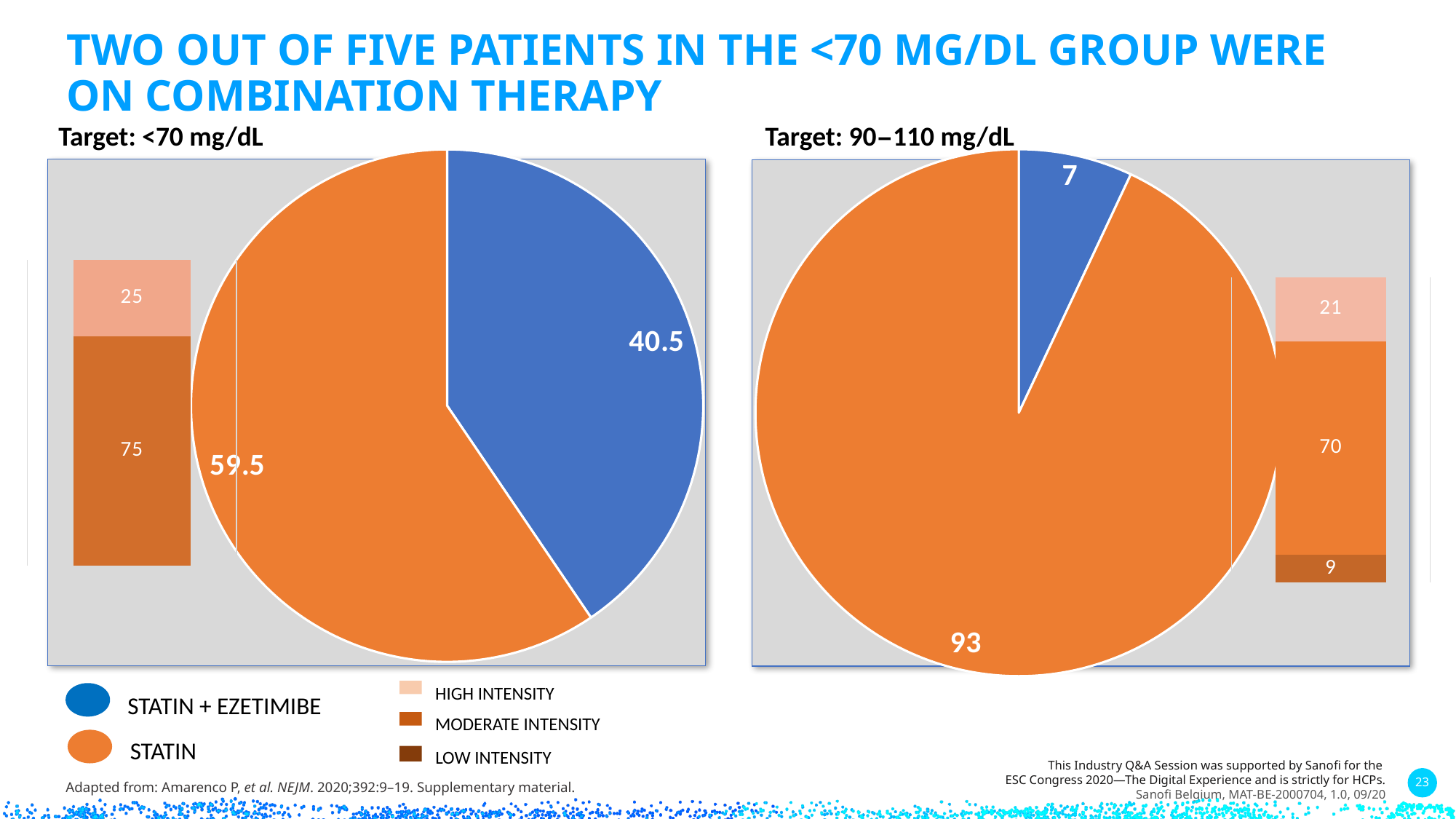
How many intensity categories does the legend list for the stacked bars? 3 In the 'Target: 90–110 mg/dL' pie chart, what is the difference between the STATIN and STATIN + EZETIMIBE values? 86 In the stacked bar next to the 'Target: 90–110 mg/dL' pie chart, what is the total of the three segments? 100 In the stacked bar next to the 'Target: 90–110 mg/dL' pie chart, what is the value for LOW INTENSITY? 9 In the 'Target: 90–110 mg/dL' pie chart, what is the value for STATIN? 93 In the 'Target: <70 mg/dL' pie chart, which slice is larger, STATIN or STATIN + EZETIMIBE? STATIN In the stacked bar next to the 'Target: <70 mg/dL' pie chart, what is the value for MODERATE INTENSITY? 75 In the 'Target: <70 mg/dL' pie chart, what is the value for STATIN + EZETIMIBE? 40.5 In the 'Target: 90–110 mg/dL' pie chart, what is the value for STATIN + EZETIMIBE? 7 In the 'Target: <70 mg/dL' pie chart, what is the value for STATIN? 59.5 What kind of chart is used to show the STATIN versus STATIN + EZETIMIBE split for each target group? Pie chart In the 'Target: <70 mg/dL' pie chart, what is the difference between the STATIN and STATIN + EZETIMIBE values? 19